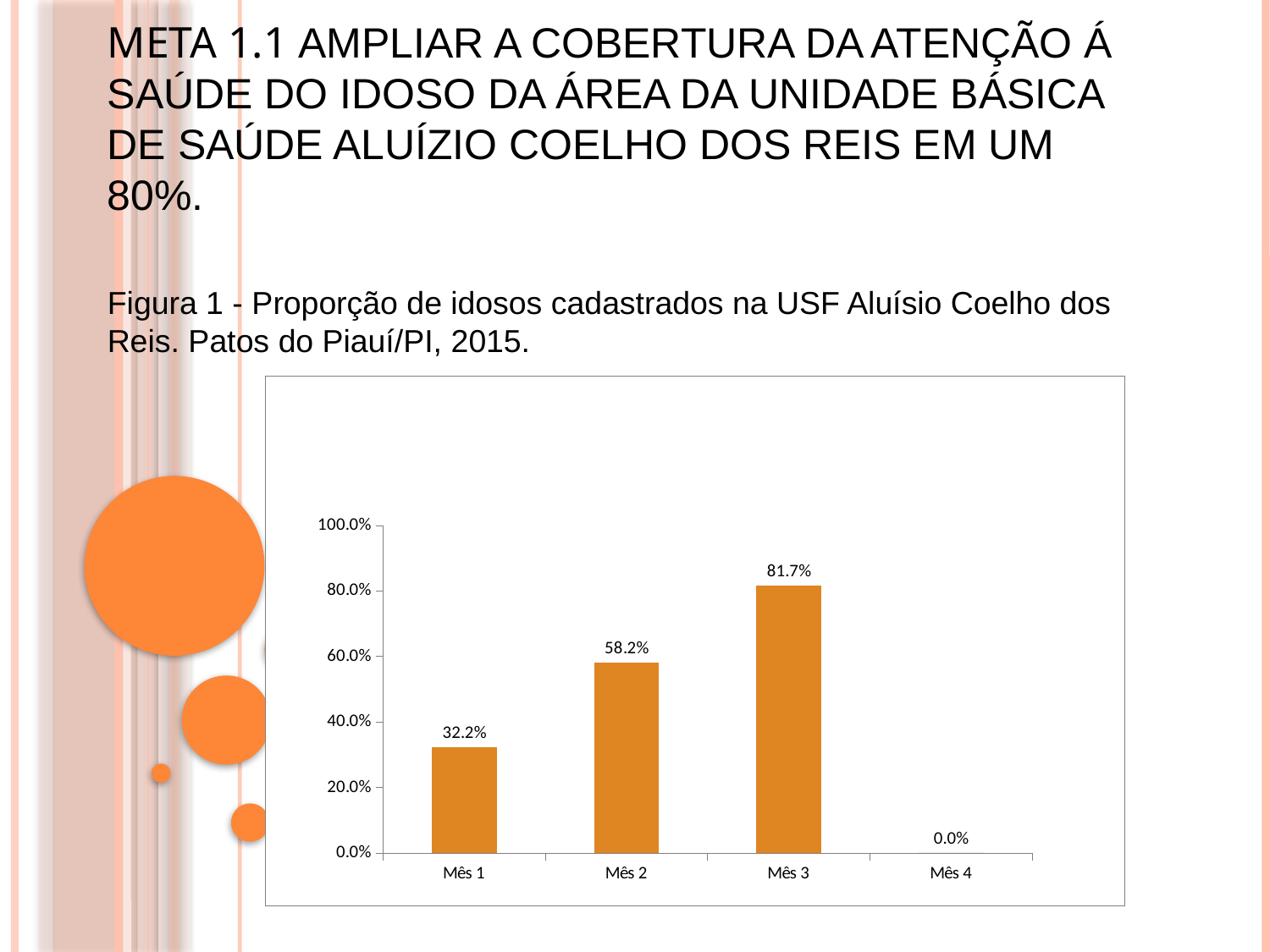
What is the value for Mês 1? 32.2% Which month has the lowest value? Mês 4 Which month has the highest value? Mês 3 What is the difference between the values for Mês 2 and Mês 1? 26.0% What is the value for Mês 2? 58.2% What is the value for Mês 4? 0.0% What kind of chart is shown on the slide? Bar chart What is the value for Mês 3? 81.7% Is the value for Mês 3 greater or less than 80.0%? greater Which is larger, the value for Mês 1 or the value for Mês 2? Mês 2 How many categories are shown on the x axis? 4 What is the difference between the values for Mês 3 and Mês 2? 23.5%